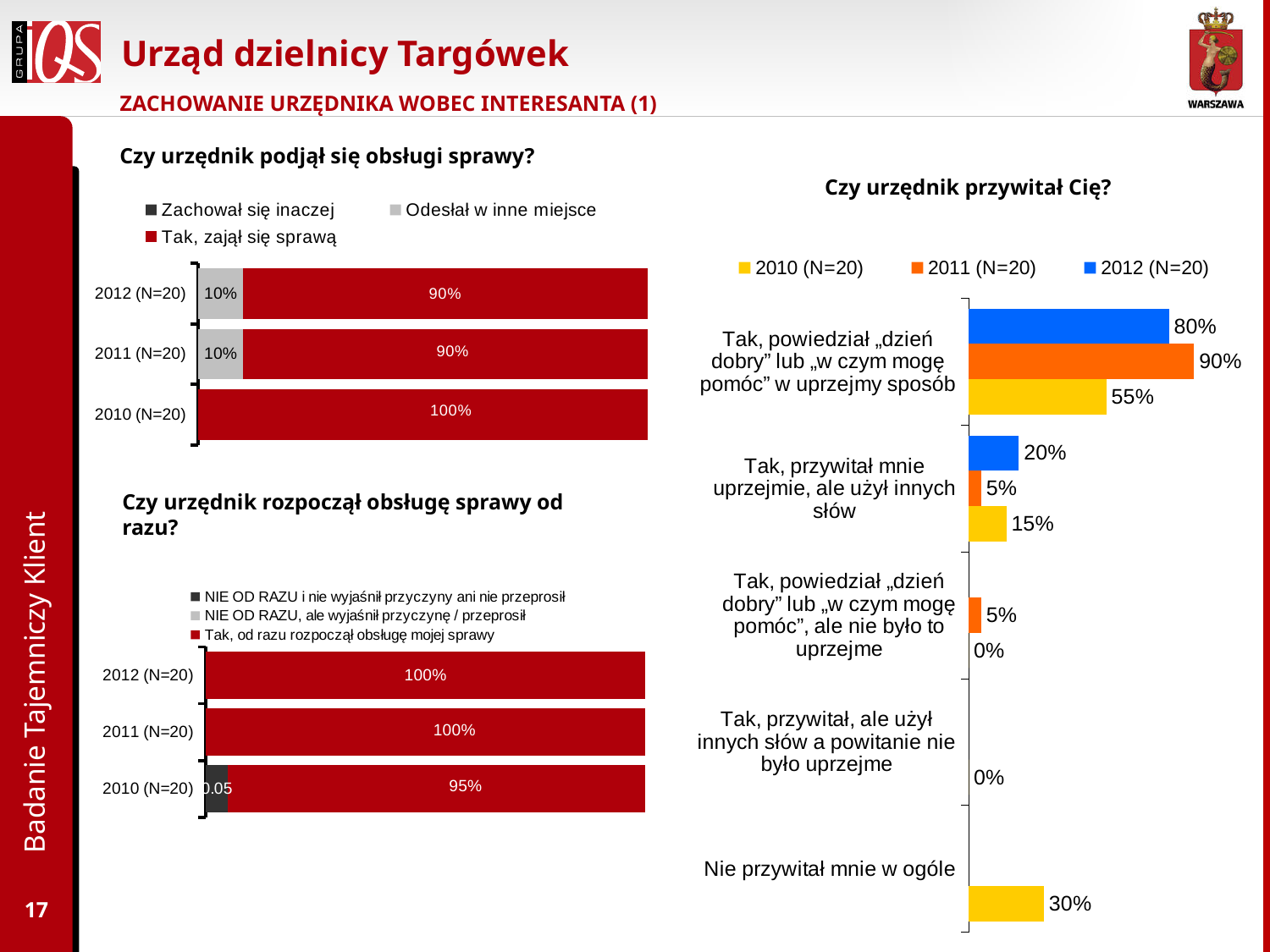
In the chart 'Czy urzędnik przywitał Cię?', how many categories are shown on the axis? 5 In the chart 'Czy urzędnik przywitał Cię?', what is the value for 2010 (N=20) in the category 'Nie przywitał mnie w ogóle'? 30% In the chart 'Czy urzędnik podjął się obsługi sprawy?', what is the value for 'Odesłał w inne miejsce' in 2012 (N=20)? 10% In the chart 'Czy urzędnik podjął się obsługi sprawy?', what is the value for 'Tak, zajął się sprawą' in 2010 (N=20)? 100% In the chart 'Czy urzędnik przywitał Cię?', which is larger in the category 'Tak, powiedział „dzień dobry” lub „w czym mogę pomóc” w uprzejmy sposób': the 2012 (N=20) value or the 2010 (N=20) value? 2012 (N=20) In the chart 'Czy urzędnik przywitał Cię?', what is the value for 2011 (N=20) in the category 'Tak, powiedział „dzień dobry” lub „w czym mogę pomóc” w uprzejmy sposób'? 90% In the chart 'Czy urzędnik rozpoczął obsługę sprawy od razu?', what is the value for 'Tak, od razu rozpoczął obsługę mojej sprawy' in 2012 (N=20)? 100% What kind of chart is 'Czy urzędnik przywitał Cię?'? bar chart In the chart 'Czy urzędnik przywitał Cię?', which year has the highest value in the category 'Tak, przywitał mnie uprzejmie, ale użył innych słów'? 2012 (N=20) In the chart 'Czy urzędnik rozpoczął obsługę sprawy od razu?', what is the value for 'Tak, od razu rozpoczął obsługę mojej sprawy' in 2010 (N=20)? 95% In the chart 'Czy urzędnik przywitał Cię?', what is the difference between the 2011 (N=20) and 2010 (N=20) values in the category 'Tak, powiedział „dzień dobry” lub „w czym mogę pomóc” w uprzejmy sposób'? 35% In the chart 'Czy urzędnik podjął się obsługi sprawy?', how many series does the legend list? 3